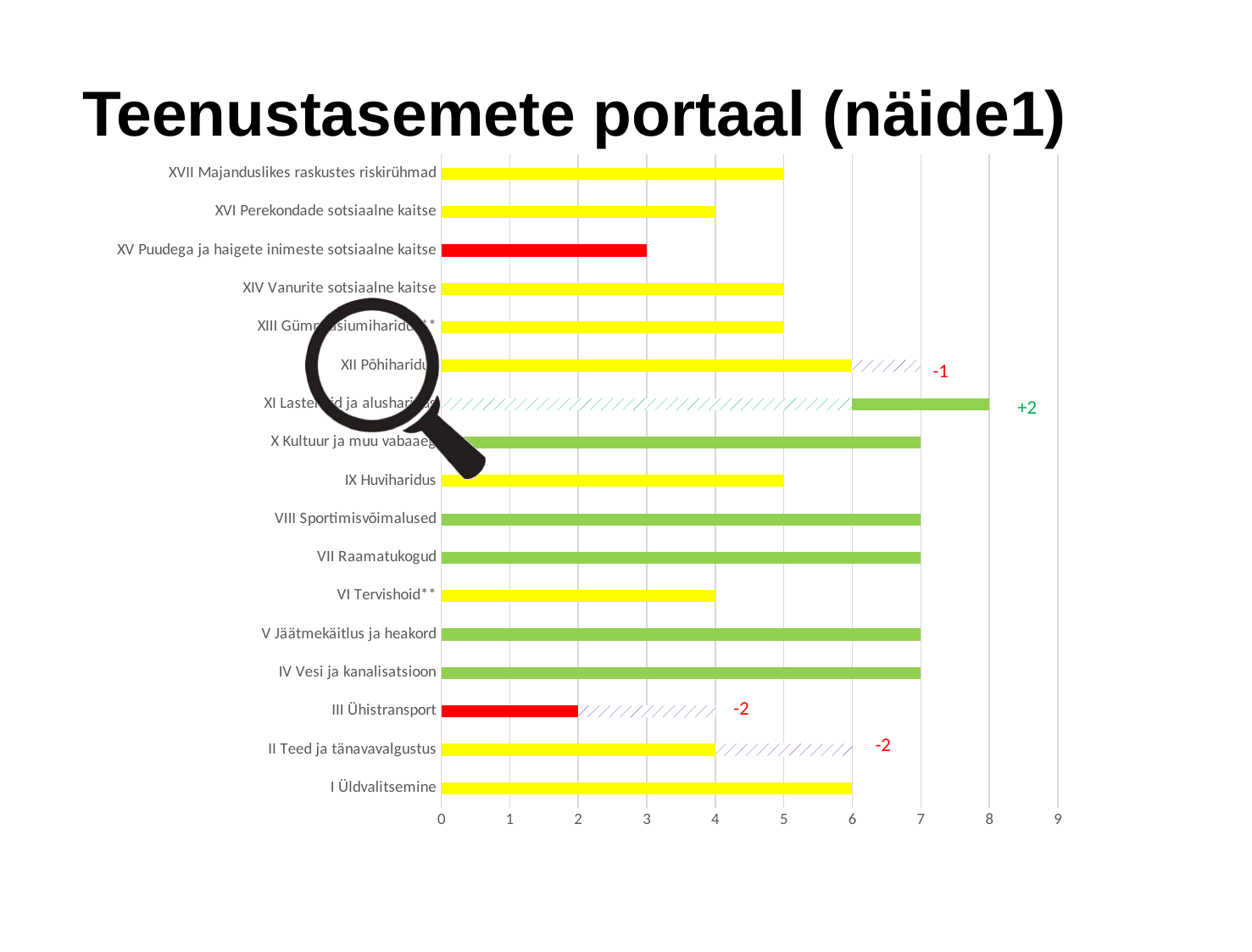
What annotation is printed next to the bar for II Teed ja tänavavalgustus? -2 What is the value for VII Raamatukogud? 7 Which category has the lowest value? III Ühistransport What is the value for IX Huviharidus? 5 How many categories are shown on the chart? 17 What is the difference between the values for VII Raamatukogud and VI Tervishoid**? 3 What is the value for III Ühistransport? 2 Is the value for IV Vesi ja kanalisatsioon greater or less than 5? greater Which is larger, the value for XVI Perekondade sotsiaalne kaitse or XVII Majanduslikes raskustes riskirühmad? XVII Majanduslikes raskustes riskirühmad What is the value for I Üldvalitsemine? 6 What kind of chart is shown on the slide? bar chart What is the value for XV Puudega ja haigete inimeste sotsiaalne kaitse? 3